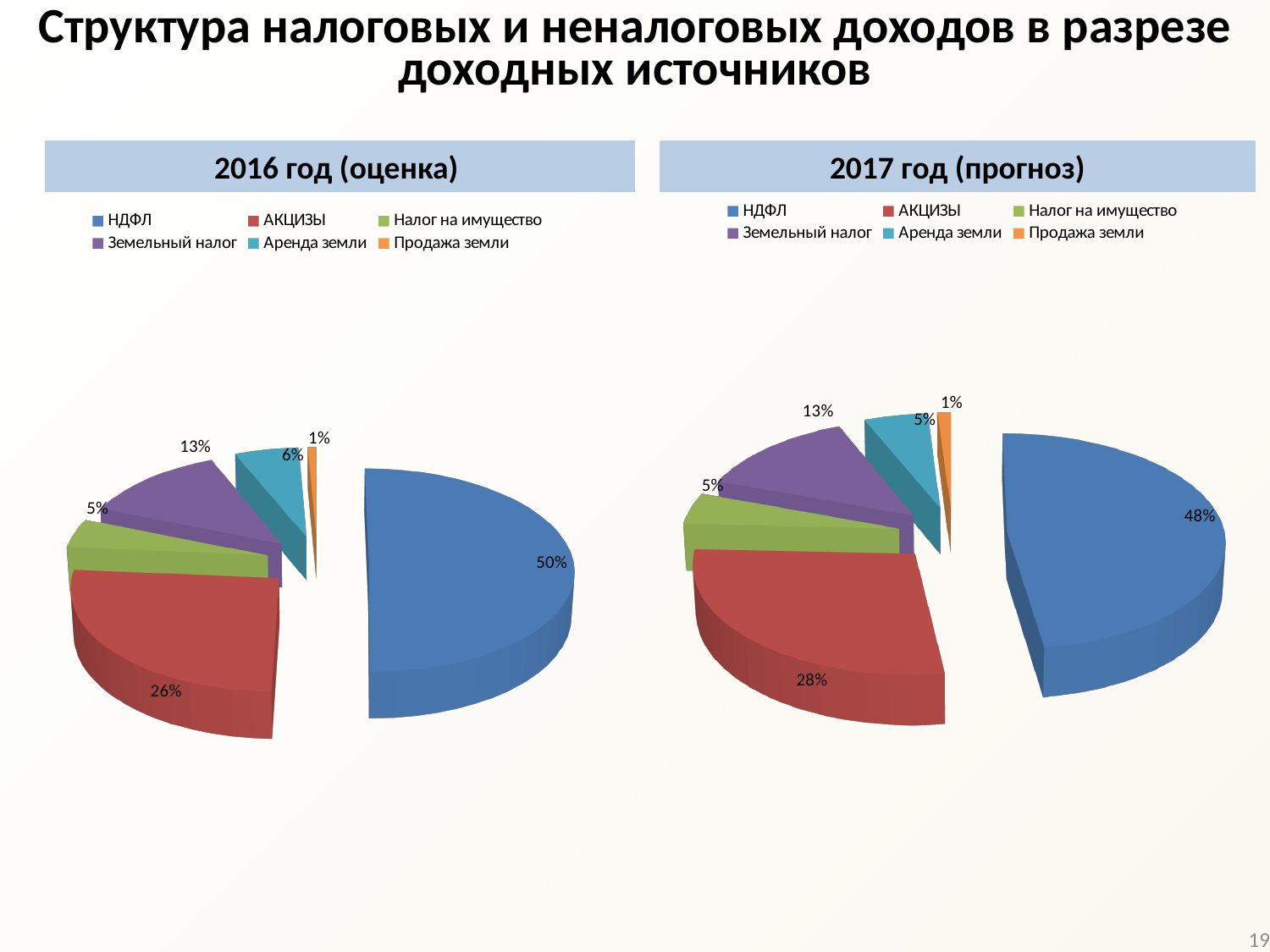
In the "2016 год (оценка)" chart, what share does НДФЛ have? 50% In the "2016 год (оценка)" chart, what share does Налог на имущество have? 5% In the "2017 год (прогноз)" chart, what share does Земельный налог have? 13% In the "2016 год (оценка)" chart, which category has the largest share? НДФЛ What type of chart is the "2017 год (прогноз)" chart? Pie chart In the "2017 год (прогноз)" chart, what share does АКЦИЗЫ have? 28% How many categories does the "2016 год (оценка)" chart show? 6 Which is larger: the share of АКЦИЗЫ in the "2016 год (оценка)" chart or in the "2017 год (прогноз)" chart? 2017 год (прогноз) In the "2017 год (прогноз)" chart, what colour is the НДФЛ slice? Blue In the "2016 год (оценка)" chart, what share does Аренда земли have? 6% In the "2016 год (оценка)" chart, what is the difference between the shares of НДФЛ and АКЦИЗЫ? 24% In the "2017 год (прогноз)" chart, which category has the smallest share? Продажа земли